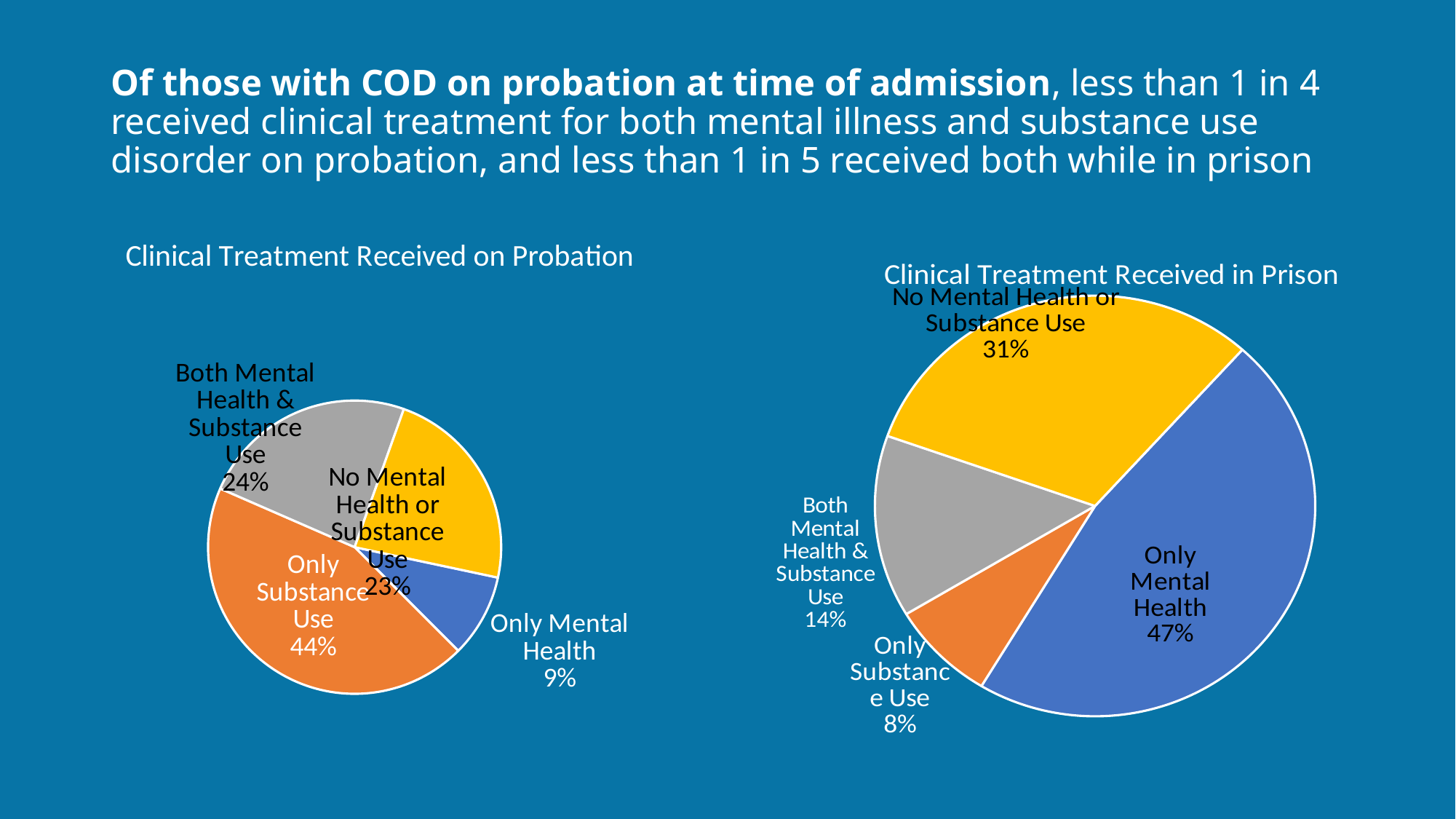
In the 'Clinical Treatment Received on Probation' chart, which category has the smallest slice? Only Mental Health In the 'Clinical Treatment Received on Probation' chart, what share is labelled for Only Substance Use? 44% What type of chart is 'Clinical Treatment Received on Probation'? Pie chart In the 'Clinical Treatment Received in Prison' chart, what share is labelled for No Mental Health or Substance Use? 31% In the 'Clinical Treatment Received on Probation' chart, what share is labelled for Both Mental Health & Substance Use? 24% In the 'Clinical Treatment Received on Probation' chart, which is larger: Both Mental Health & Substance Use or No Mental Health or Substance Use? Both Mental Health & Substance Use In the 'Clinical Treatment Received on Probation' chart, which category has the largest slice? Only Substance Use In the 'Clinical Treatment Received in Prison' chart, what share is labelled for Only Mental Health? 47% In the 'Clinical Treatment Received in Prison' chart, what is the difference between the Only Mental Health share and the No Mental Health or Substance Use share? 16% How many slices does the 'Clinical Treatment Received in Prison' chart have? 4 In the 'Clinical Treatment Received in Prison' chart, which category has the smallest slice? Only Substance Use In the 'Clinical Treatment Received in Prison' chart, what colour is the Only Mental Health slice? Blue